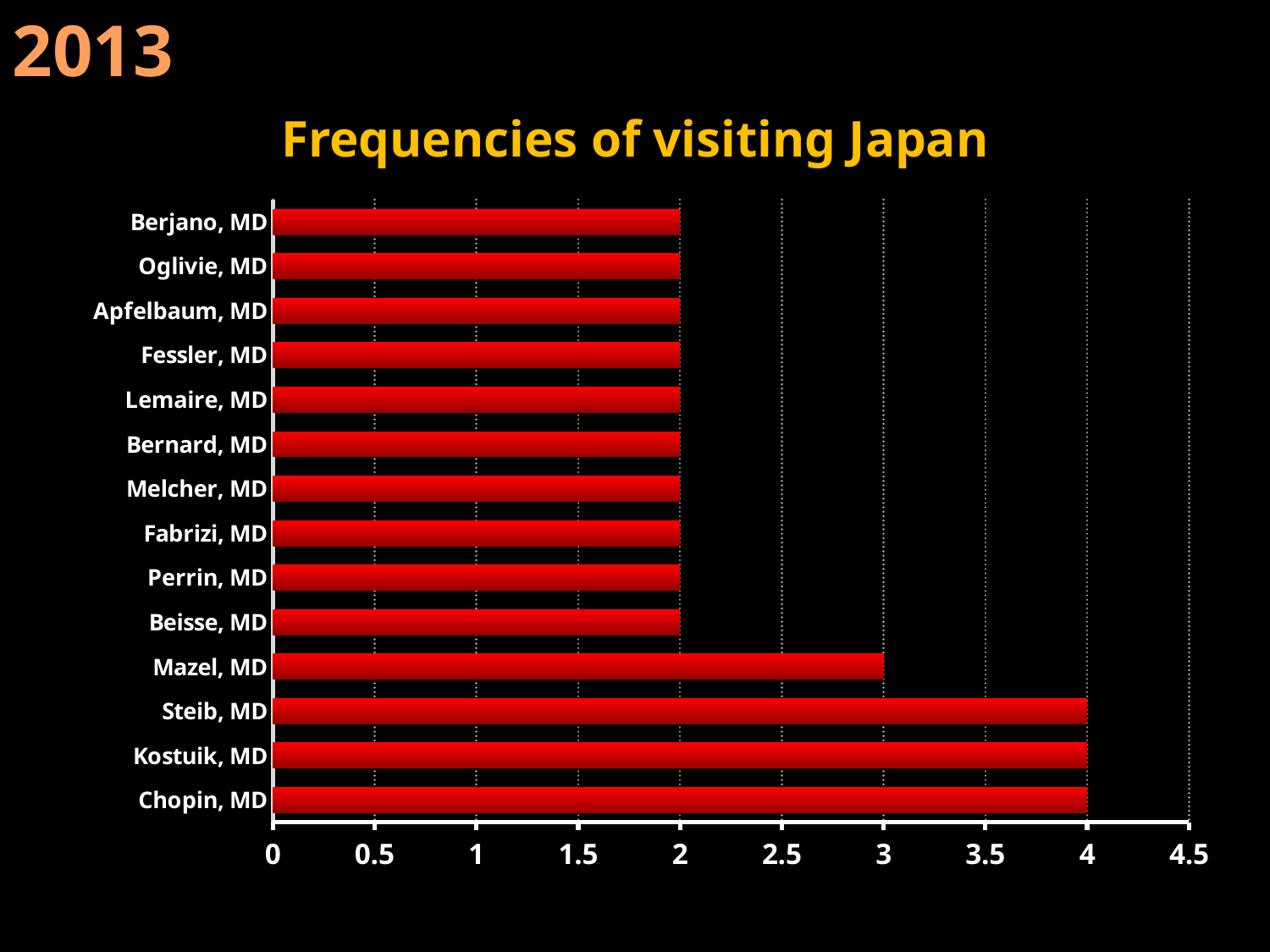
What is the value for Chopin, MD? 4 How many categories (names) are shown on the chart? 14 Which is larger, the value for Mazel, MD or the value for Perrin, MD? Mazel, MD Is the value for Fessler, MD greater or less than 3? less What kind of chart is shown on the slide? bar chart Is the value for Mazel, MD greater or less than 2.5? greater What is the value for Steib, MD? 4 What is the difference between the values for Kostuik, MD and Mazel, MD? 1 What is the title of the chart? Frequencies of visiting Japan What is the value for Mazel, MD? 3 What is the value for Berjano, MD? 2 What is the difference between the values for Mazel, MD and Beisse, MD? 1